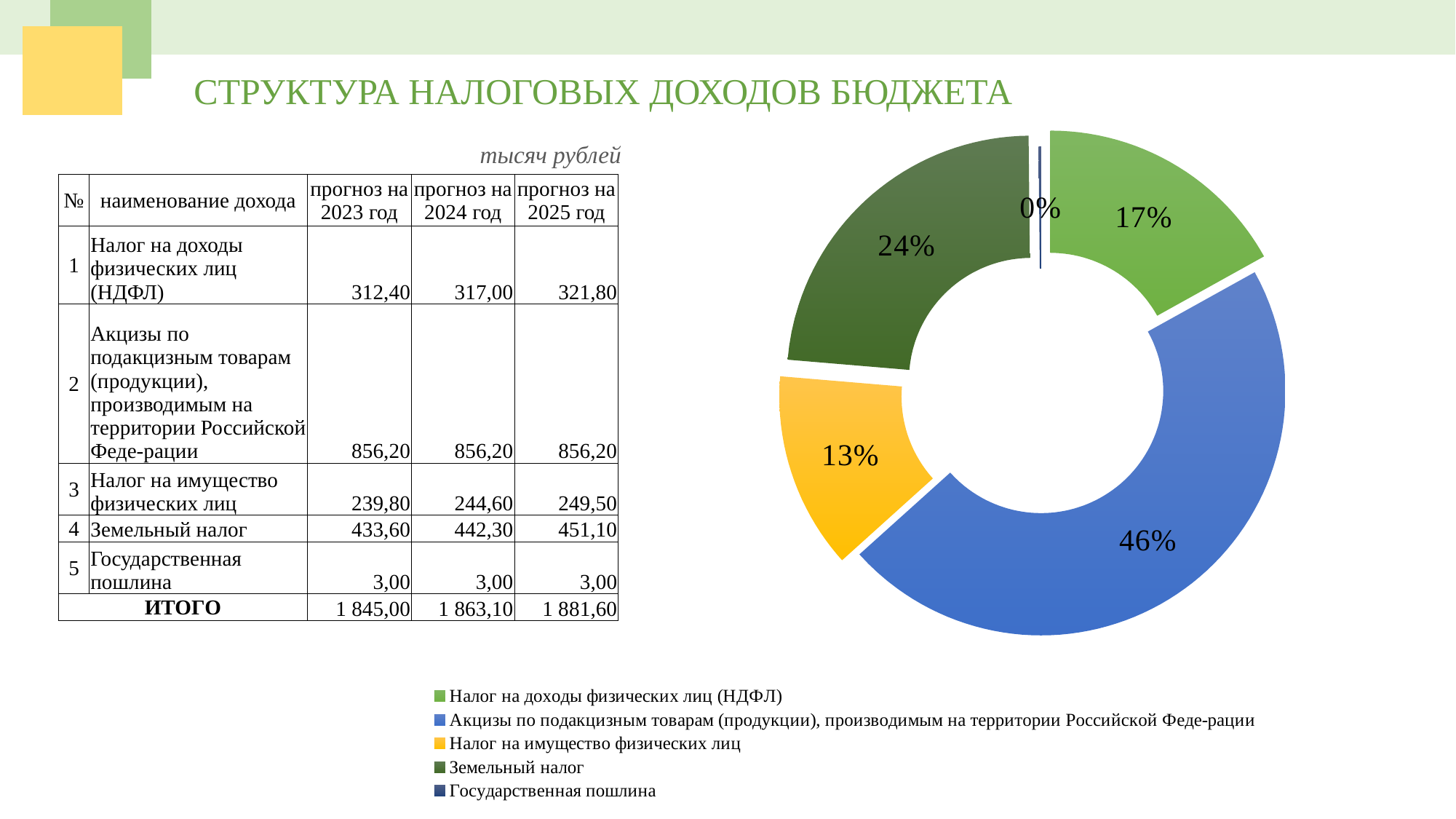
What colour represents "Налог на имущество физических лиц" in the doughnut chart? Yellow What share of the doughnut chart does "Налог на имущество физических лиц" have? 13% What is the difference in percentage points between the share of "Акцизы по подакцизным товарам" and the share of "Земельный налог" in the doughnut chart? 22 percentage points Which category has the smallest share in the doughnut chart? Государственная пошлина What share of the doughnut chart does "Государственная пошлина" have? 0% What share of the doughnut chart does "Налог на доходы физических лиц (НДФЛ)" have? 17% Which category has the largest share in the doughnut chart? Акцизы по подакцизным товарам (продукции), производимым на территории Российской Феде-рации In the doughnut chart, which is larger: the share of "Земельный налог" or the share of "Налог на доходы физических лиц (НДФЛ)"? Земельный налог How many categories does the legend of the doughnut chart list? 5 What kind of chart is shown on the slide? Doughnut (pie) chart